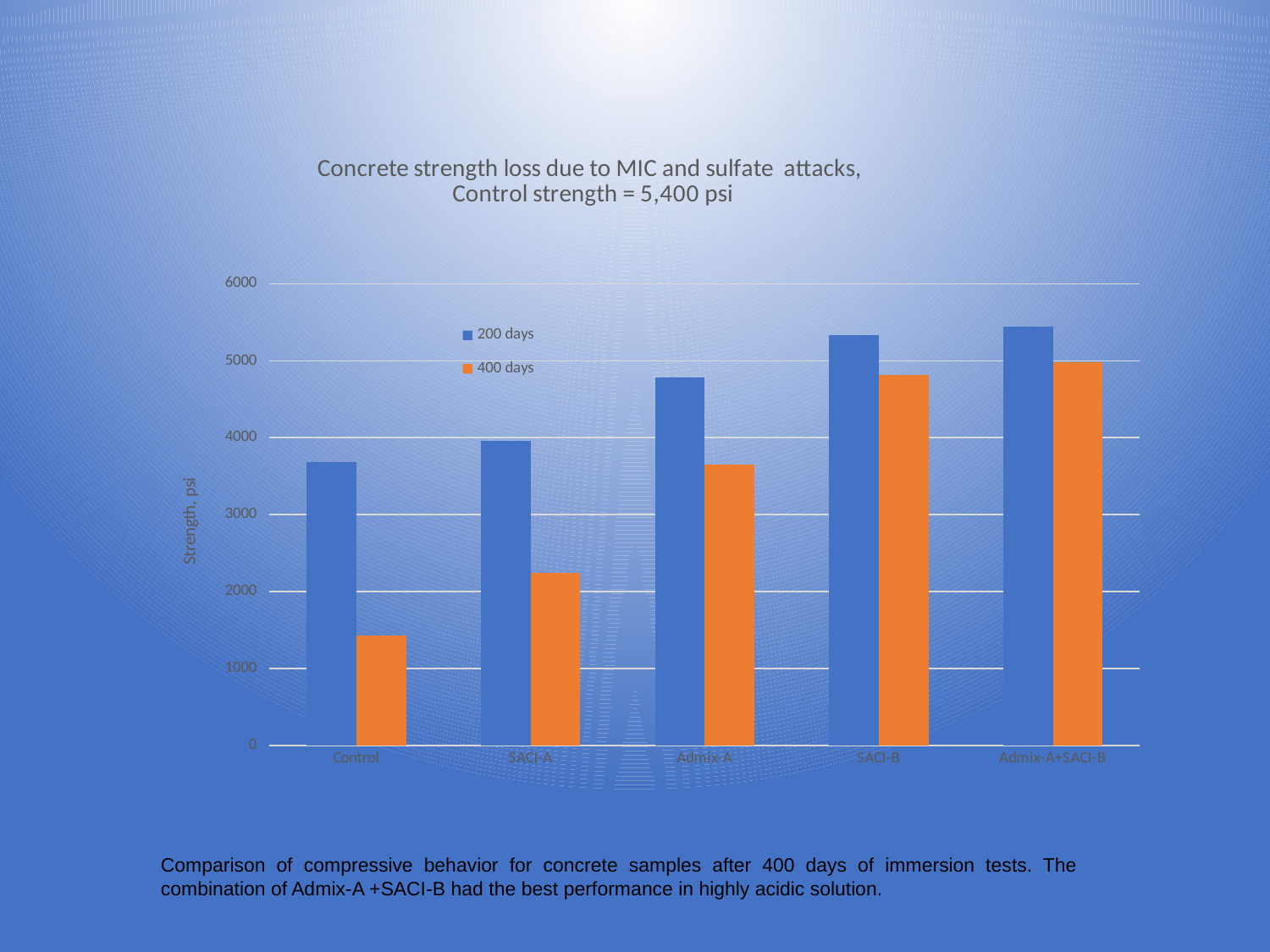
Which category has the lowest value for the 200 days series? Control Is the 400 days value for Admix-A greater or less than 3000? greater Do the 400 days values rise or fall moving from Control to Admix-A+SACI-B along the x axis? rise Is the 400 days value for Control greater or less than 2000? less For SACI-A, which is larger: the 200 days value or the 400 days value? 200 days Which category has the highest value for the 400 days series? Admix-A+SACI-B How many categories are shown on the x axis of the chart? 5 What kind of chart is shown on the slide? bar chart Is the 200 days value for SACI-B greater or less than 5000? greater Which category has the lowest value for the 400 days series? Control How many series does the chart's legend list? 2 What is the label of the chart's y axis? Strength, psi